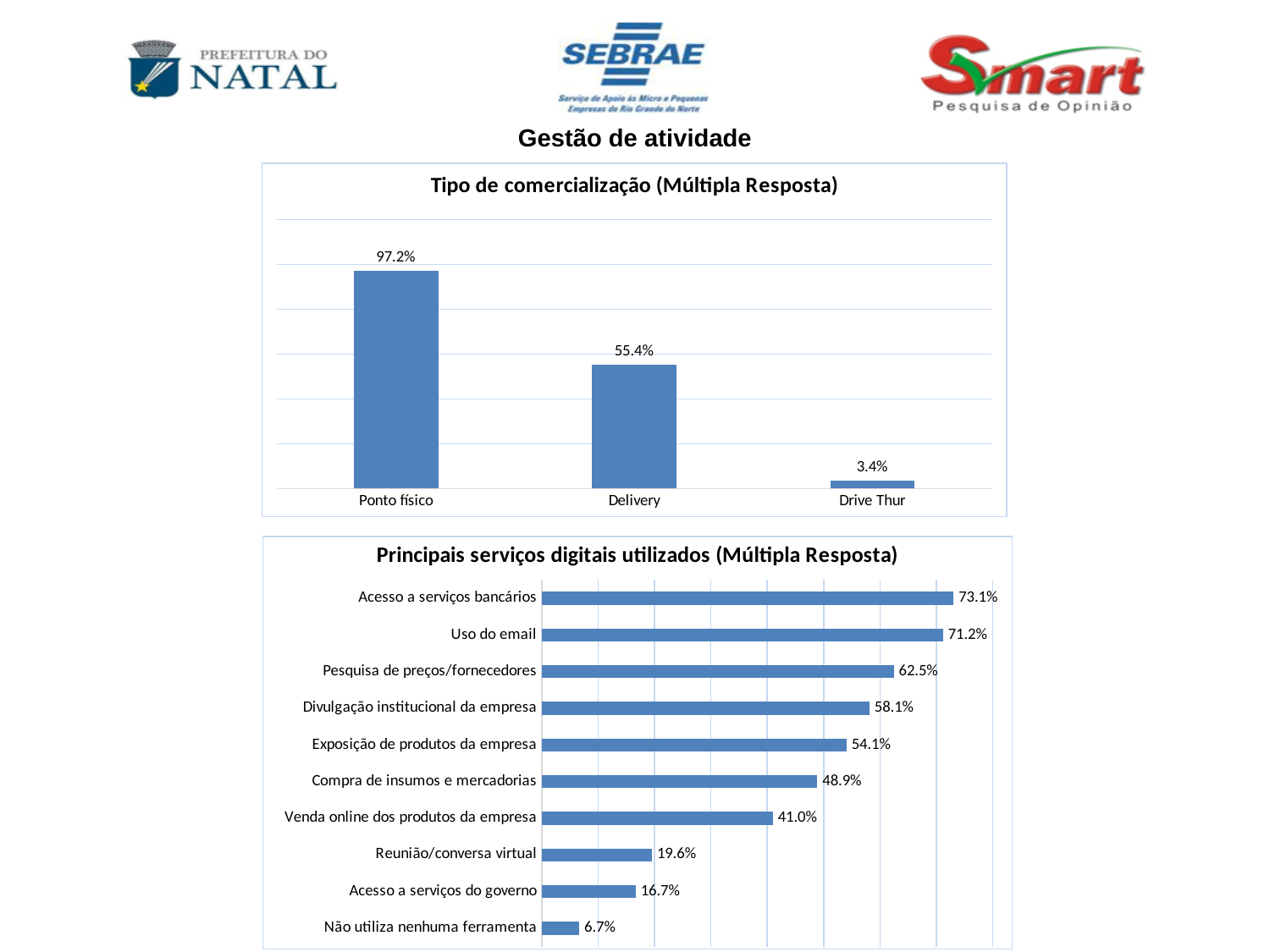
In the 'Tipo de comercialização (Múltipla Resposta)' chart, what is the value for Ponto físico? 97.2% In the 'Principais serviços digitais utilizados (Múltipla Resposta)' chart, what is the value for Uso do email? 71.2% In the 'Principais serviços digitais utilizados (Múltipla Resposta)' chart, which is larger: Compra de insumos e mercadorias or Reunião/conversa virtual? Compra de insumos e mercadorias In the 'Tipo de comercialização (Múltipla Resposta)' chart, which category has the lowest value? Drive Thur In the 'Tipo de comercialização (Múltipla Resposta)' chart, how many categories are shown? 3 In the 'Principais serviços digitais utilizados (Múltipla Resposta)' chart, how many categories are shown? 10 In the 'Tipo de comercialização (Múltipla Resposta)' chart, what is the value for Delivery? 55.4% What kind of chart is the 'Tipo de comercialização (Múltipla Resposta)' chart? Bar chart In the 'Principais serviços digitais utilizados (Múltipla Resposta)' chart, which category has the highest value? Acesso a serviços bancários In the 'Principais serviços digitais utilizados (Múltipla Resposta)' chart, what is the value for Venda online dos produtos da empresa? 41.0% In the 'Principais serviços digitais utilizados (Múltipla Resposta)' chart, what is the difference between Acesso a serviços do governo and Não utiliza nenhuma ferramenta? 10.0% In the 'Tipo de comercialização (Múltipla Resposta)' chart, what is the difference between Ponto físico and Delivery? 41.8%